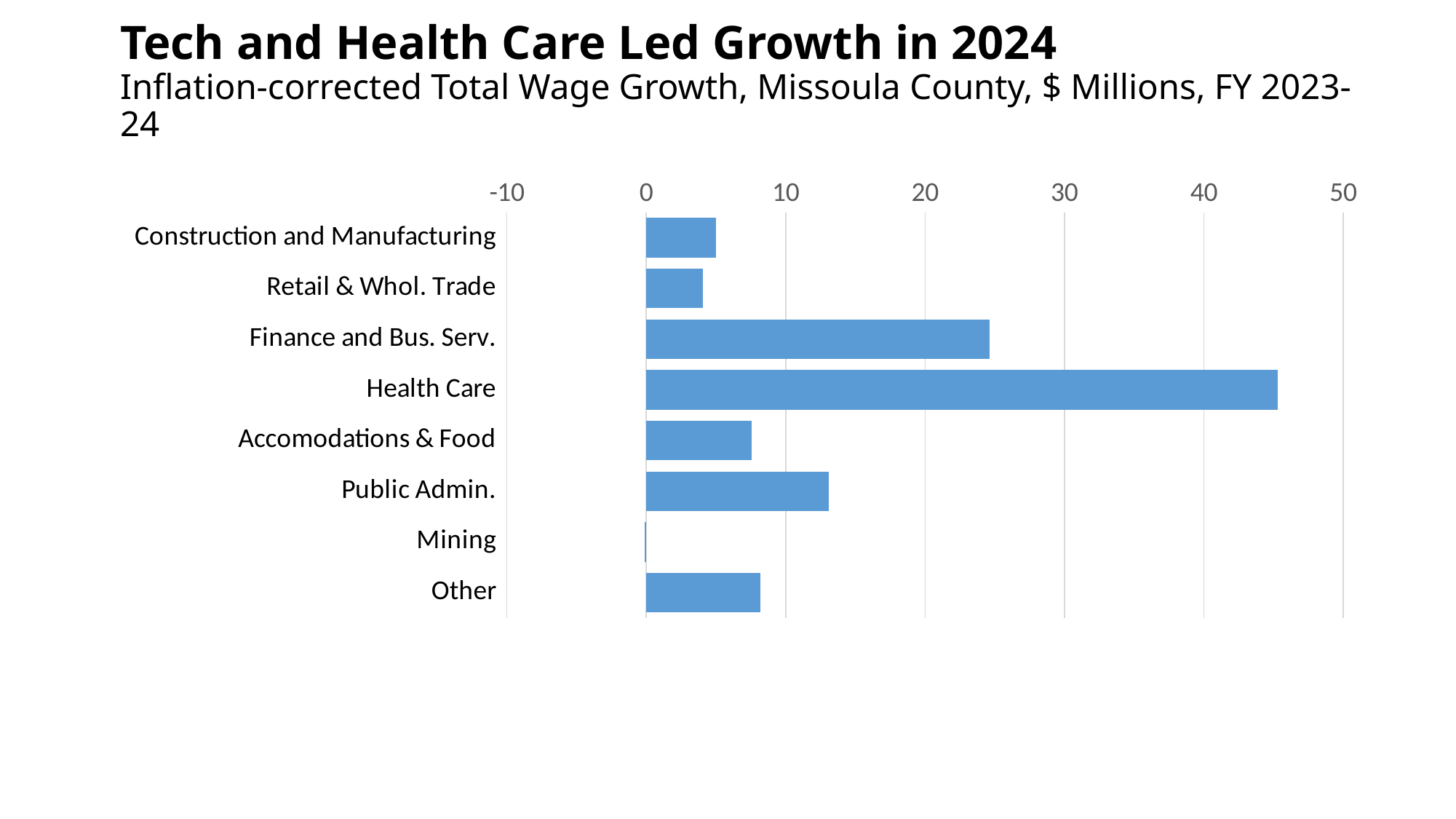
Which category has the highest inflation-corrected total wage growth? Health Care Which is larger, the value for Public Admin. or the value for Accomodations & Food? Public Admin. Is the value for Finance and Bus. Serv. greater or less than 20? greater Is the value for Public Admin. greater or less than 10? greater What kind of chart is shown on the slide? bar chart Is the value for Health Care greater or less than 40? greater Which category has the lowest inflation-corrected total wage growth? Mining What is the highest tick value shown on the horizontal axis? 50 What is the title of the chart? Tech and Health Care Led Growth in 2024 Which is larger, the value for Finance and Bus. Serv. or the value for Public Admin.? Finance and Bus. Serv. How many categories are plotted in the chart? 8